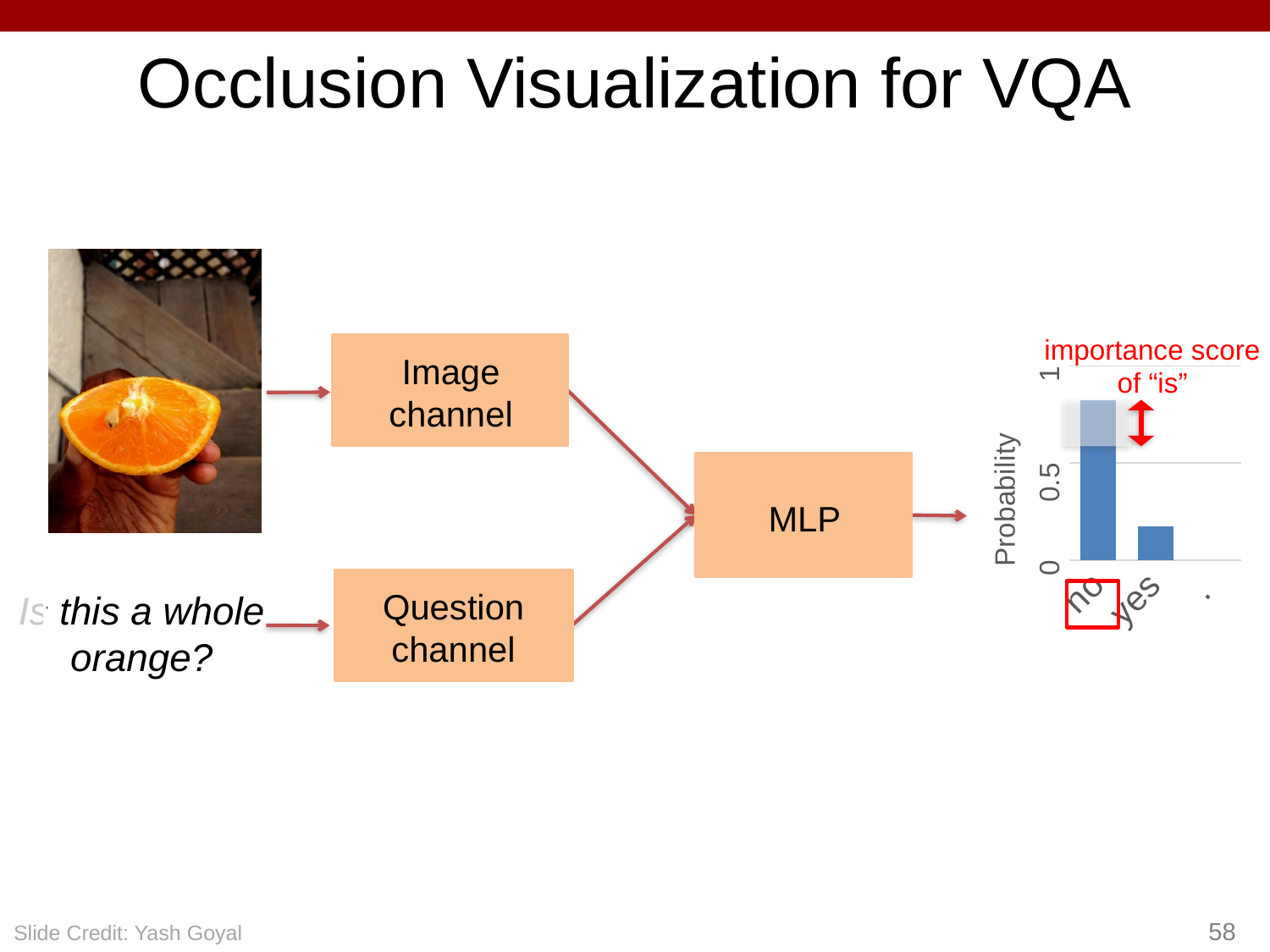
Which category has the lowest probability in the bar chart? yes Is the probability for "no" greater or less than 0.5? greater What is the label of the y axis of the bar chart? Probability Is the probability for "yes" greater or less than 0.5? less What kind of chart is shown on the right of the slide? bar chart Which category has the highest probability in the bar chart? no Which is larger in the bar chart, the probability for "no" or for "yes"? no What is the highest tick value shown on the y axis of the bar chart? 1